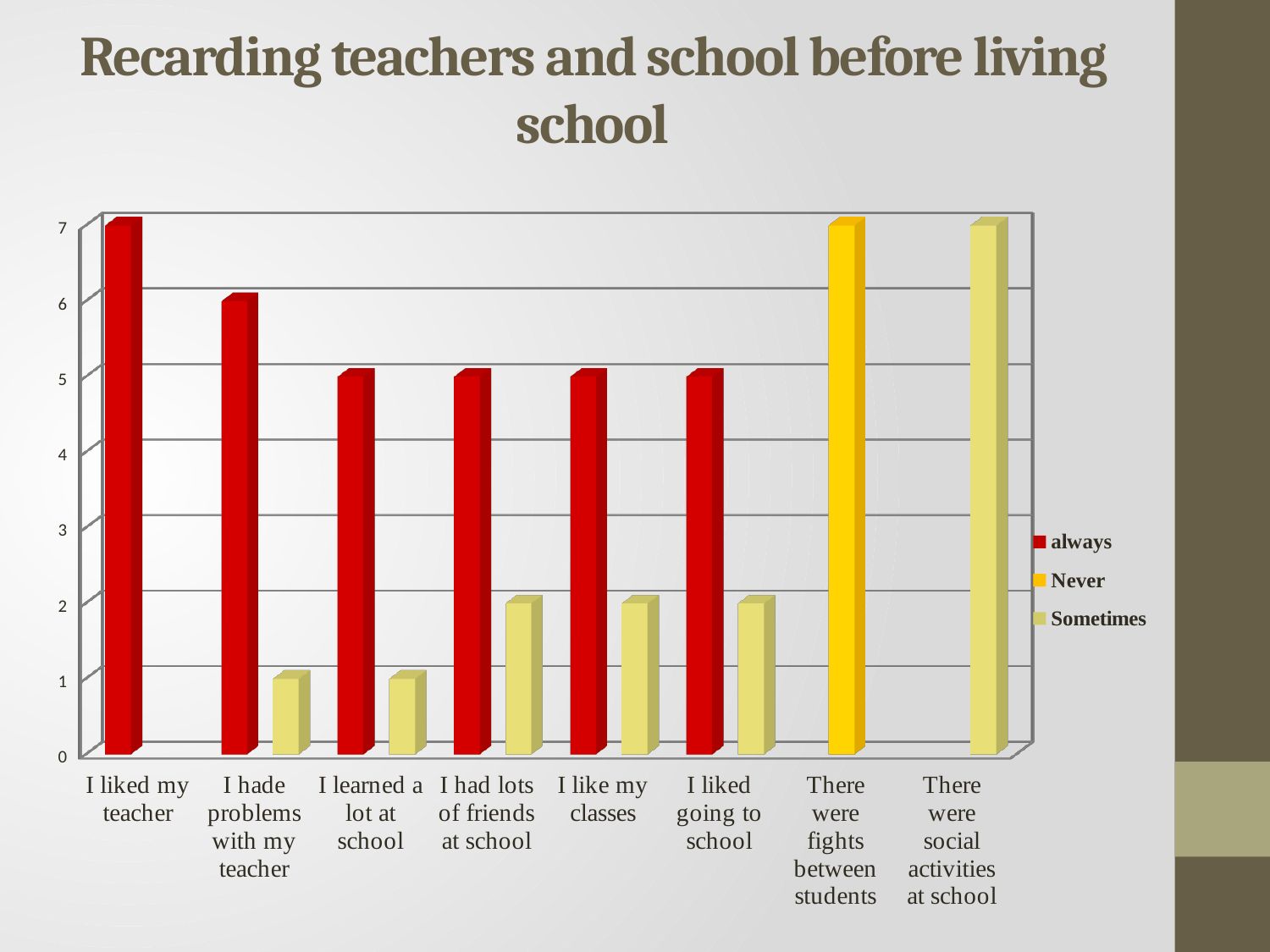
What is the 'always' value for 'I liked my teacher'? 7 What colour represents the 'Never' series in the legend? yellow How many categories are shown along the x axis? 8 What is the 'Sometimes' value for 'I had lots of friends at school'? 2 Which category has the lowest 'always' value among those with a red bar? I learned a lot at school, I had lots of friends at school, I like my classes, I liked going to school (all 5) How many series does the legend list? 3 What type of chart is shown on the slide? bar chart Which is larger for 'I liked going to school': the 'always' value or the 'Sometimes' value? always What is the difference between the 'always' value and the 'Sometimes' value for 'I hade problems with my teacher'? 5 What is the 'Sometimes' value for 'There were social activities at school'? 7 What is the 'always' value for 'I hade problems with my teacher'? 6 What is the 'Never' value for 'There were fights between students'? 7